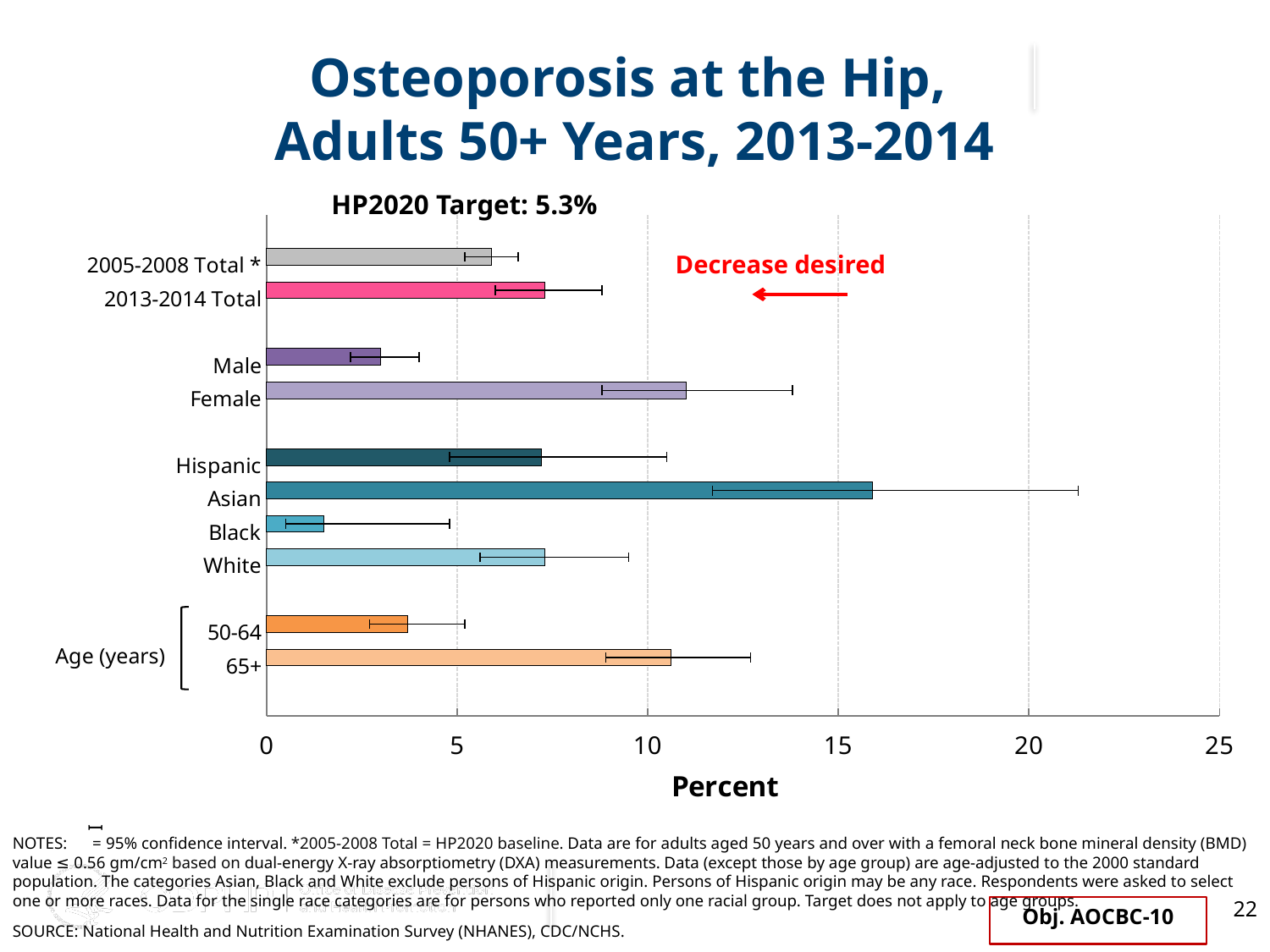
Which category has the highest percentage of osteoporosis at the hip? Asian Is the value for Male greater or less than 5? less Which category has the lowest percentage of osteoporosis at the hip? Black What kind of chart is shown on the slide? bar chart How many bars (categories) are plotted in the chart? 10 Is the value for Asian greater or less than 15? greater Is the value for Black greater or less than 5? less What is the label of the x axis? Percent Which is larger, the value for Female or the value for Male? Female What is the HP2020 Target shown on the slide? 5.3% Which is larger, the value for 65+ or the value for 50-64? 65+